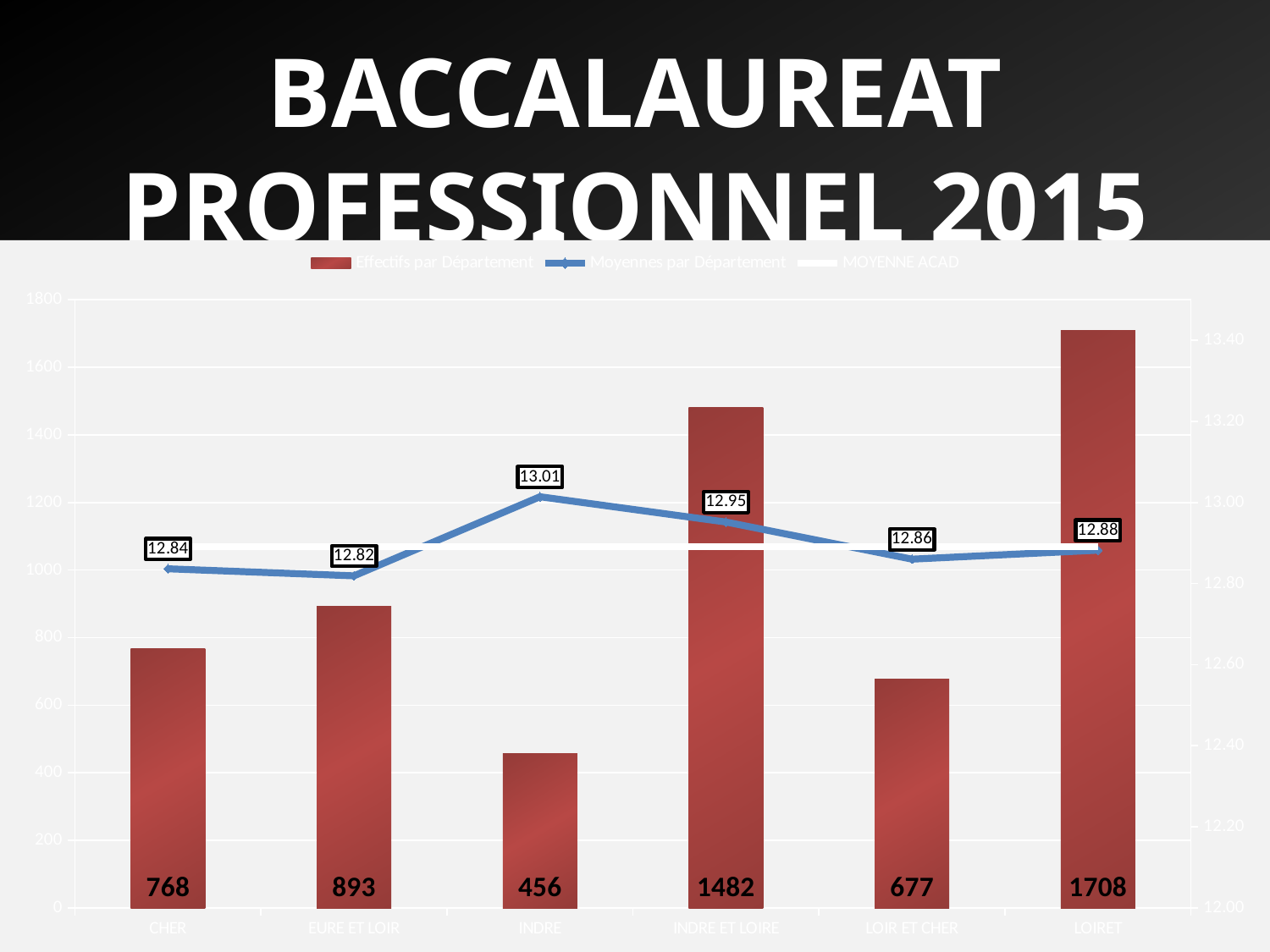
What is the Moyennes par Département value for INDRE? 13.01 Which department has the highest Effectifs par Département? LOIRET Which has a larger Effectifs par Département, CHER or EURE ET LOIR? EURE ET LOIR What is the Effectifs par Département value for LOIR ET CHER? 677 How many series does the legend list? 3 Which department has the lowest Effectifs par Département? INDRE What is the difference in Effectifs par Département between LOIRET and INDRE ET LOIRE? 226 Which department has the lowest Moyennes par Département? EURE ET LOIR How many departments are shown on the x axis? 6 Is the Effectifs par Département value for INDRE greater or less than 600? less What is the value of Effectifs par Département for INDRE ET LOIRE? 1482 What is the title of the slide? BACCALAUREAT PROFESSIONNEL 2015